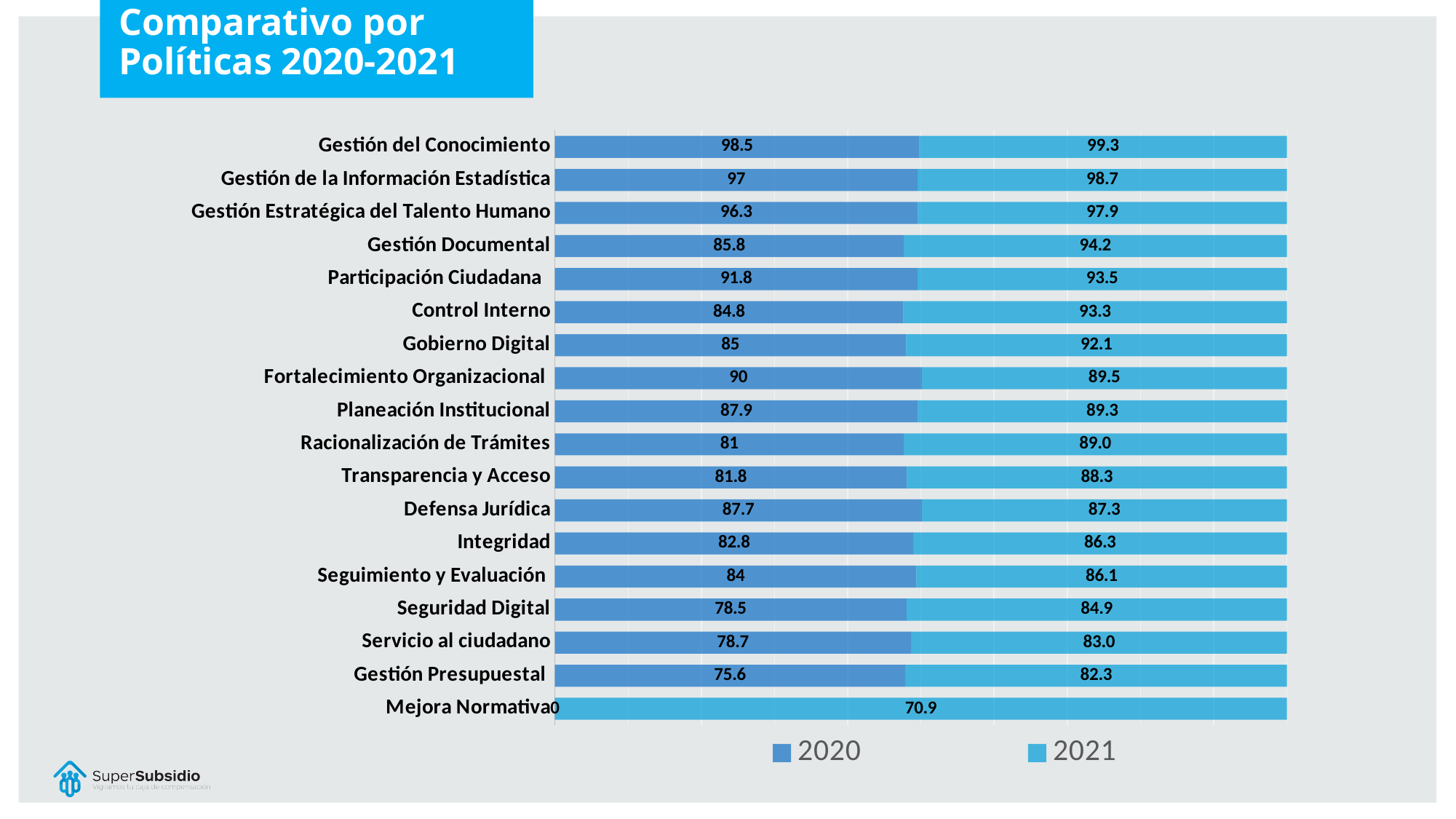
What is the difference between the 2021 and 2020 values for Seguridad Digital? 6.4 What is the 2021 value for Control Interno? 93.3 What is the 2021 value for Mejora Normativa? 70.9 For Fortalecimiento Organizacional, which year has the larger value, 2020 or 2021? 2020 Which policy has the lowest 2021 value? Mejora Normativa How many policies are listed on the chart? 18 How many series does the legend list? 2 What is the difference between the 2021 and 2020 values for Gestión Documental? 8.4 Which policy has the highest 2021 value? Gestión del Conocimiento What is the 2020 value for Gestión Documental? 85.8 Which policy has the highest 2020 value? Gestión del Conocimiento What kind of chart is shown on the slide? Bar chart